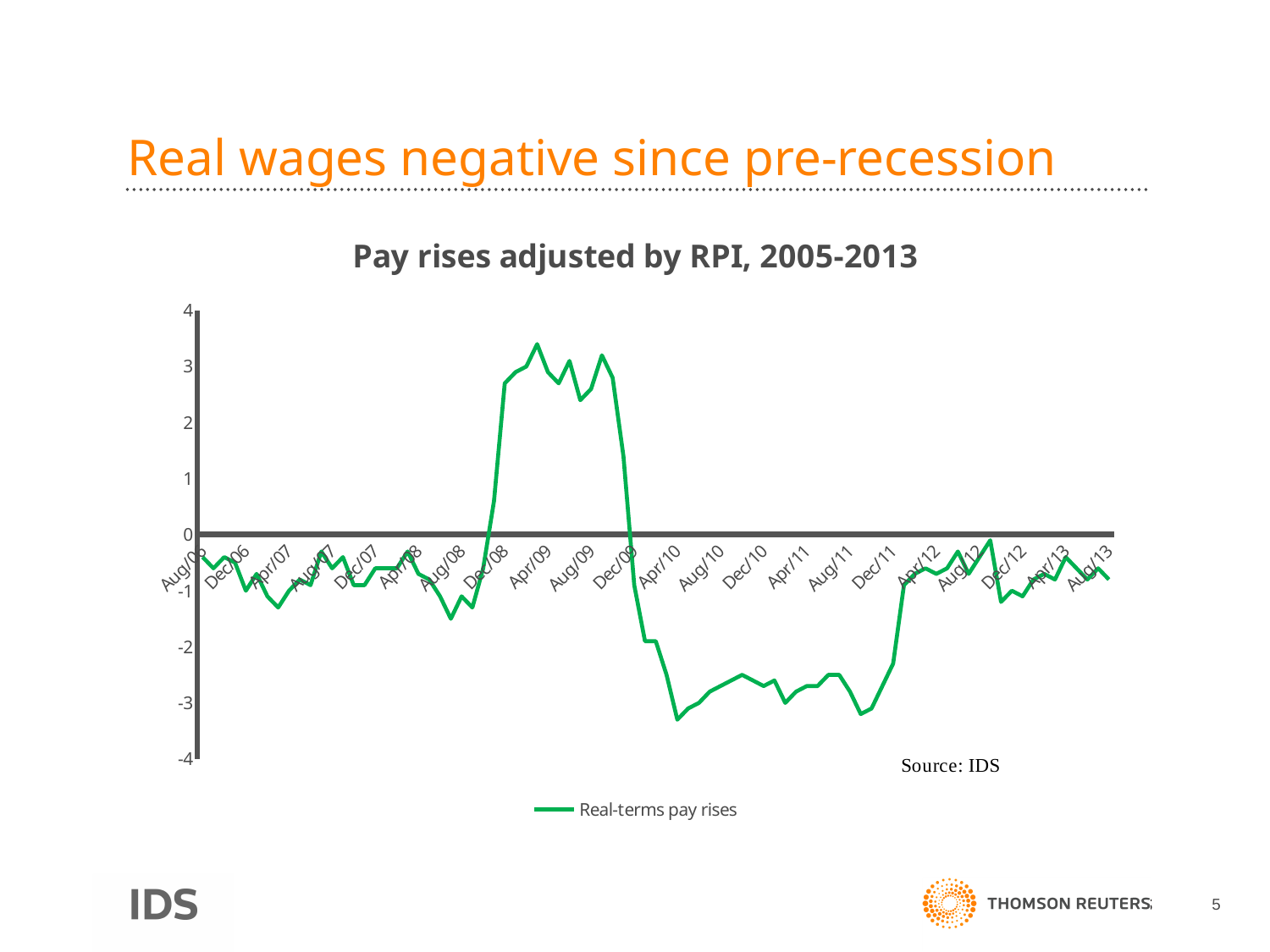
Is the value for Aug/08 greater or less than 0? less What is the title of the chart? Pay rises adjusted by RPI, 2005-2013 Is the value for Aug/09 greater or less than 2? greater Which is larger, the value for Apr/09 or the value for Apr/10? Apr/09 Around which x-axis label does the line reach its highest value? Apr/09 What is the name of the series shown in the legend? Real-terms pay rises How many series does the legend list? 1 Is the value for Aug/10 greater or less than -2? less Does the line rise or fall between Aug/08 and Apr/09? rise What kind of chart is shown on the slide? line chart Does the line rise or fall between Apr/09 and Apr/10? fall